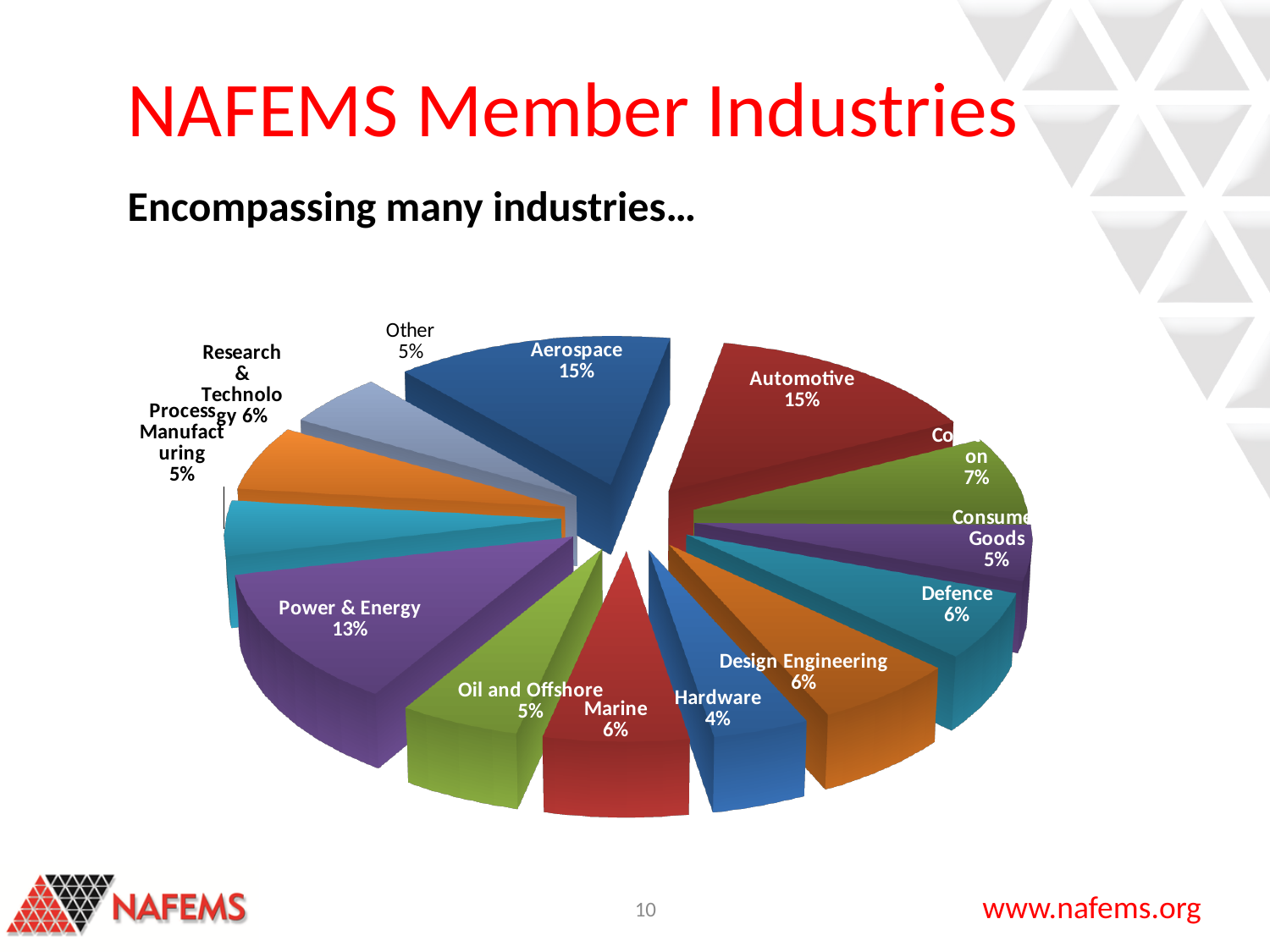
What kind of chart is shown on the slide? pie chart What is the title of the slide containing the pie chart? NAFEMS Member Industries What percentage is shown for Oil and Offshore? 5% What percentage is shown for Automotive? 15% What share of NAFEMS member industries is Power & Energy? 13% What percentage is shown for Hardware? 4% What percentage is shown for Research & Technology? 6% Which industry has the smallest share in the pie chart? Hardware How many slices does the pie chart have? 13 What share of the pie does Marine represent? 6% Which has the larger share, Defence or Consumer Goods? Defence What is the difference in percentage points between Aerospace and Power & Energy? 2